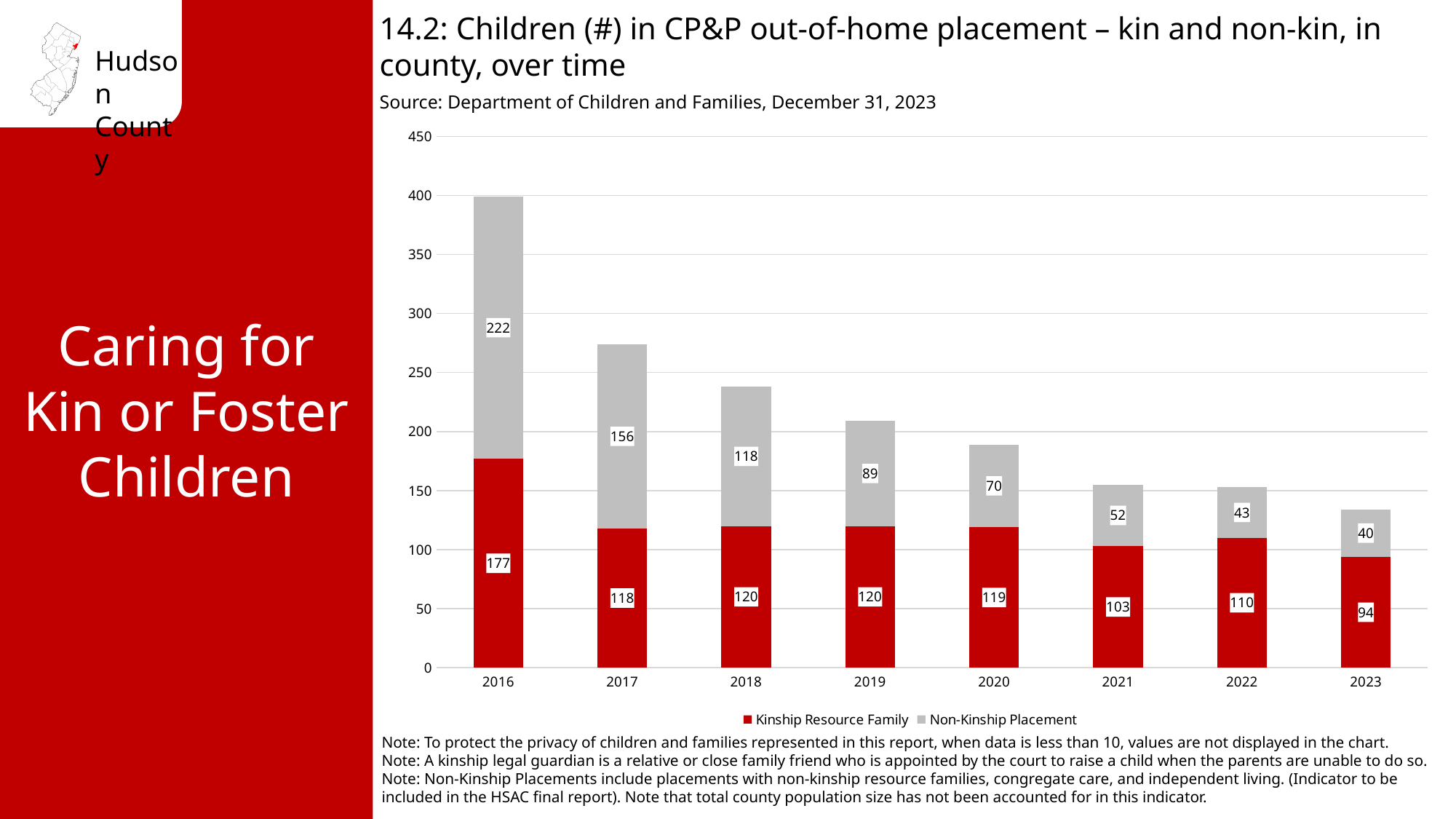
What is the total of the stacked bar for 2016? 399 Which year has the lowest Kinship Resource Family value? 2023 What is the total of the stacked bar for 2022? 153 Which is larger in 2021: Kinship Resource Family or Non-Kinship Placement? Kinship Resource Family How many years are shown on the x axis? 8 What is the difference between the Non-Kinship Placement values for 2016 and 2017? 66 What kind of chart is shown? Stacked bar chart What is the Non-Kinship Placement value for 2019? 89 What is the Non-Kinship Placement value for 2023? 40 Which year has the highest Non-Kinship Placement value? 2016 How many series does the legend list? 2 What is the Kinship Resource Family value for 2016? 177